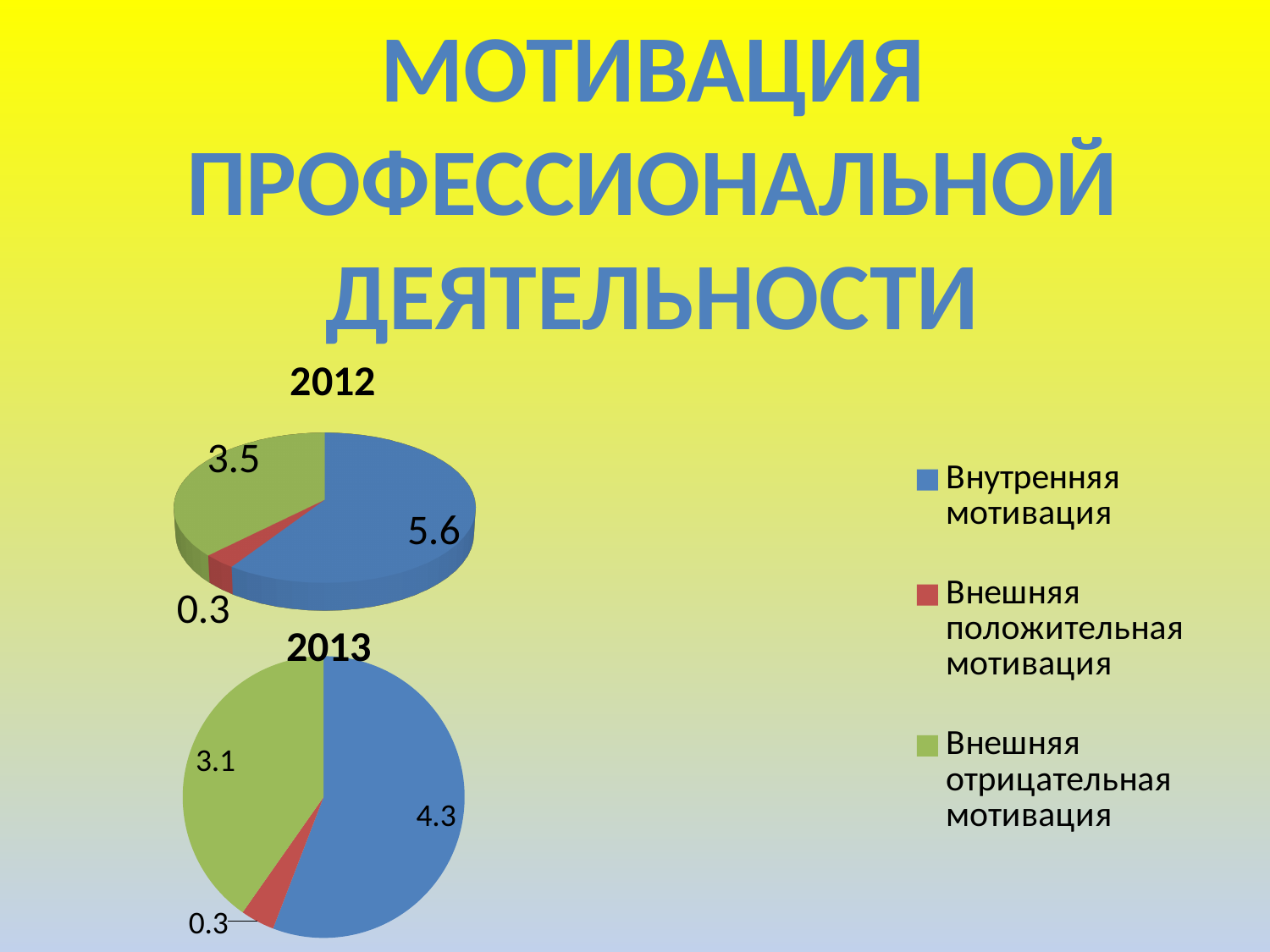
In the 2012 pie chart, what is the difference between Внутренняя мотивация and Внешняя отрицательная мотивация? 2.1 In the 2012 pie chart, which category has the largest value? Внутренняя мотивация In the 2013 pie chart, which category has the smallest value? Внешняя положительная мотивация In the 2012 pie chart, what is the value for Внешняя отрицательная мотивация? 3.5 What kind of chart is the 2012 chart? Pie chart In the 2013 pie chart, what is the value for Внутренняя мотивация? 4.3 In the 2013 pie chart, what is the value for Внешняя положительная мотивация? 0.3 Which is larger: Внешняя отрицательная мотивация in the 2012 chart or in the 2013 chart? 2012 In the 2012 pie chart, what is the value for Внутренняя мотивация? 5.6 How many series does the legend list? 3 What is the difference between the Внутренняя мотивация value in the 2012 chart and in the 2013 chart? 1.3 How many slices does the 2013 pie chart have? 3